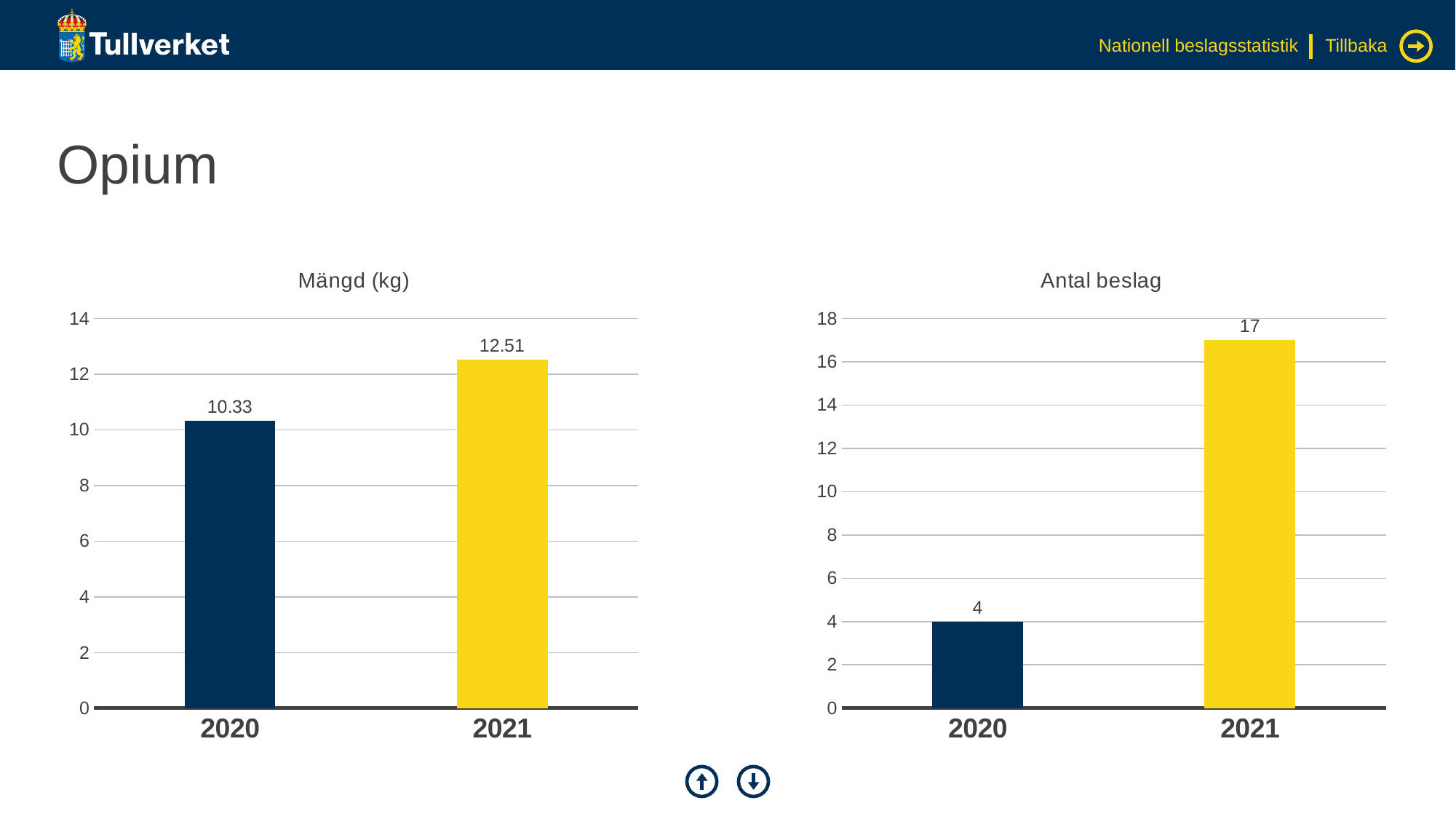
In the 'Antal beslag' chart, what is the value for 2021? 17 In the 'Antal beslag' chart, what is the value for 2020? 4 In the 'Antal beslag' chart, do the values rise or fall from 2020 to 2021? rise How many categories are shown in the 'Antal beslag' chart? 2 In the 'Antal beslag' chart, what is the difference between the values for 2021 and 2020? 13 In the 'Mängd (kg)' chart, which year has the lowest value? 2020 In the 'Antal beslag' chart, which year has the highest value? 2021 In the 'Mängd (kg)' chart, is the value for 2021 greater or less than 12? greater What kind of chart is the 'Mängd (kg)' chart? bar chart In the 'Mängd (kg)' chart, what is the value for 2021? 12.51 In the 'Mängd (kg)' chart, what is the difference between the values for 2021 and 2020? 2.18 In the 'Mängd (kg)' chart, what is the value for 2020? 10.33